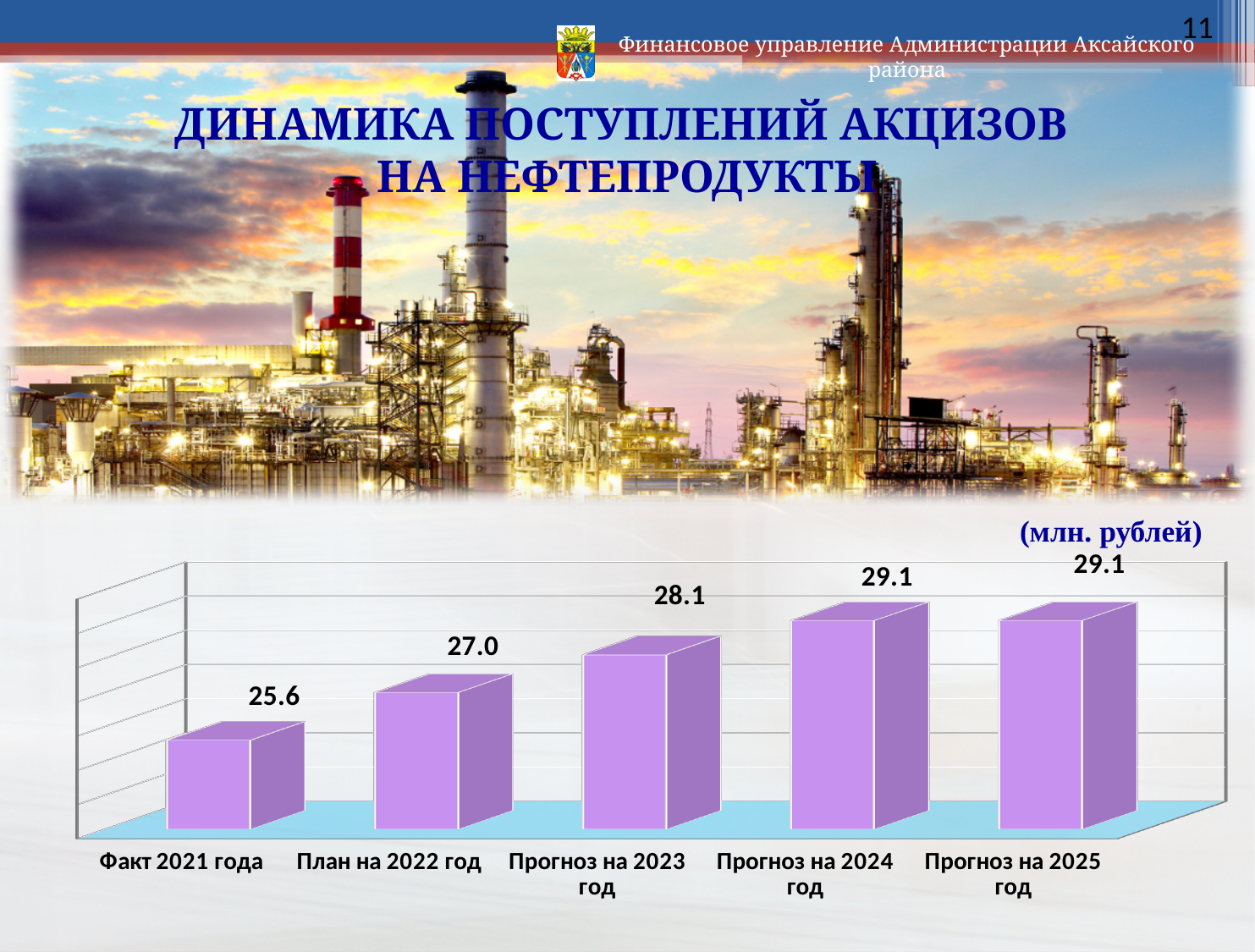
Which is larger, the value for План на 2022 год or the value for Прогноз на 2023 год? Прогноз на 2023 год What is the value for План на 2022 год? 27.0 What is the value for Прогноз на 2024 год? 29.1 What kind of chart is shown on the slide? Bar chart What is the value for Прогноз на 2025 год? 29.1 What is the value for Факт 2021 года? 25.6 How many categories are shown in the chart? 5 What is the difference between the values for Прогноз на 2024 год and Факт 2021 года? 3.5 In what units are the chart values given? млн. рублей What is the value for Прогноз на 2023 год? 28.1 What is the difference between the values for Прогноз на 2023 год and План на 2022 год? 1.1 Which category has the lowest value? Факт 2021 года